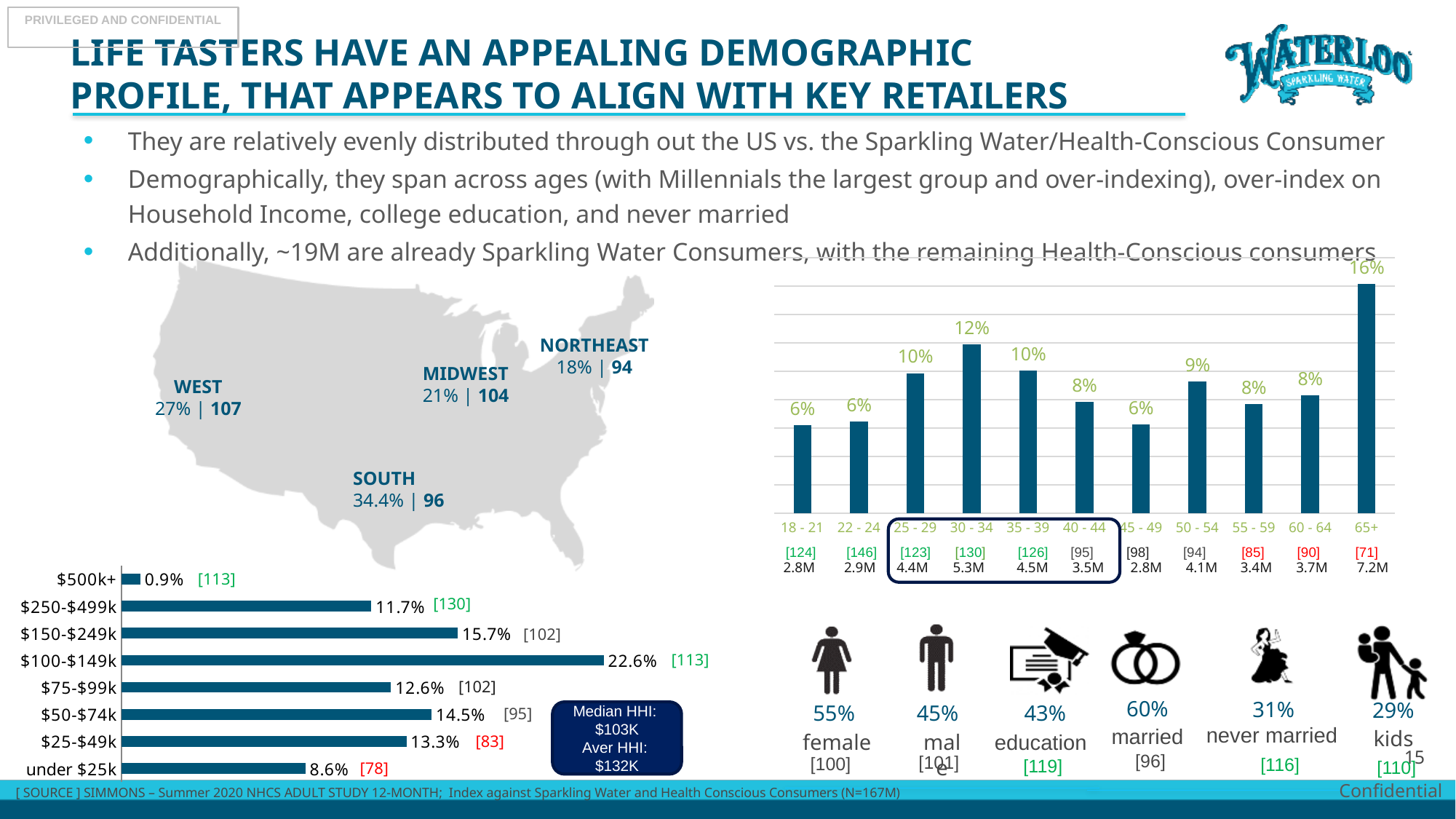
In the age distribution bar chart on the right, which age group has the highest value? 65+ In the age distribution bar chart on the right, what is the value for the 30 - 34 age group? 12% In the household income bar chart at the bottom left, which income category has the lowest value? $500k+ In the household income bar chart at the bottom left, which is larger: the value for $50-$74k or the value for $25-$49k? $50-$74k What kind of chart is the age distribution chart on the right? bar chart In the age distribution bar chart on the right, what is the difference between the 65+ group and the 18 - 21 group? 10% In the household income bar chart at the bottom left, which income category has the highest value? $100-$149k In the household income bar chart at the bottom left, what is the value for $100-$149k? 22.6% In the age distribution bar chart on the right, which is larger: the value for 50 - 54 or the value for 45 - 49? 50 - 54 In the household income bar chart at the bottom left, what is the difference between the $150-$249k value and the under $25k value? 7.1% In the age distribution bar chart on the right, how many age groups are shown? 11 In the household income bar chart at the bottom left, how many income categories are shown? 8